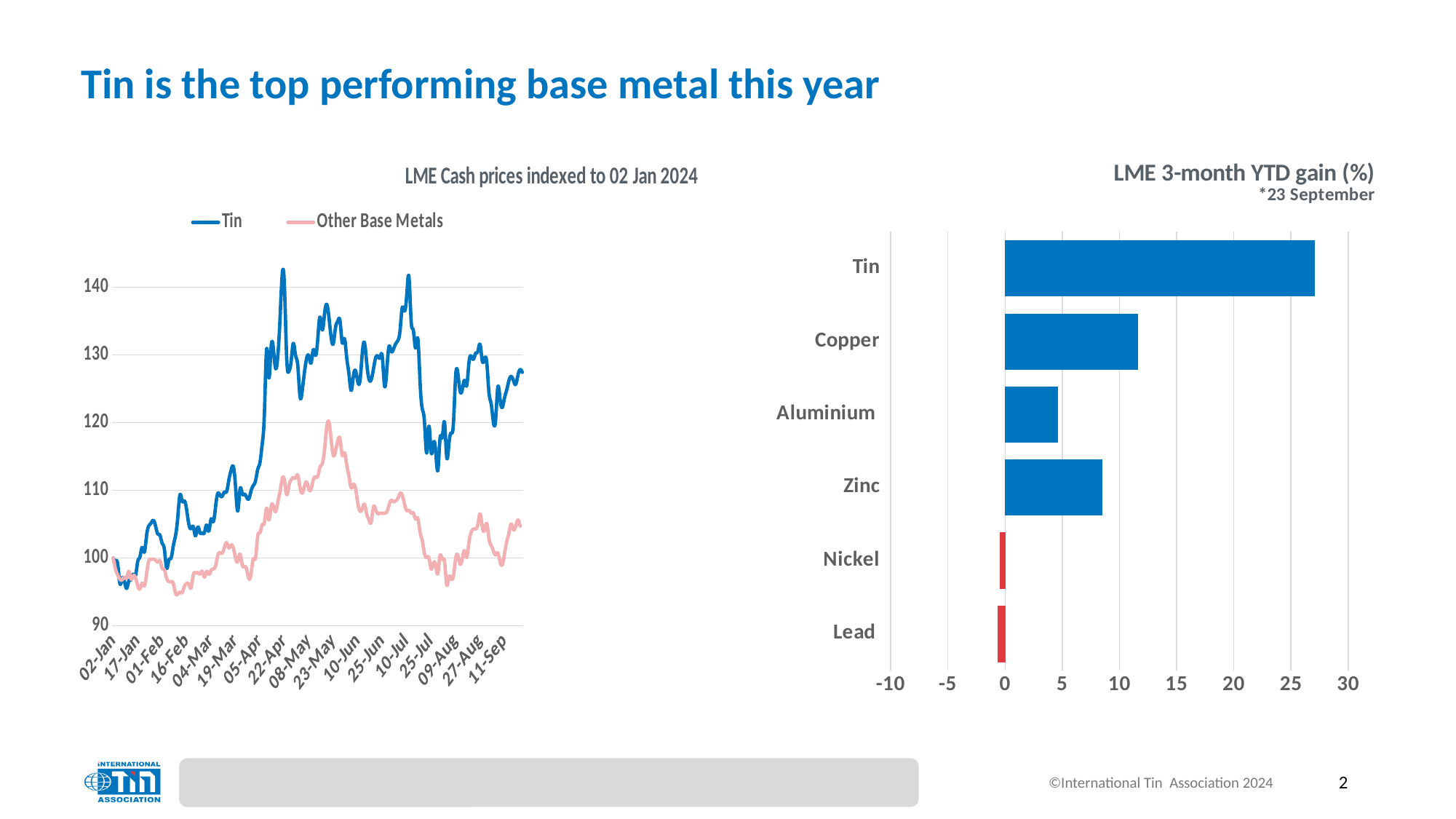
In the 'LME Cash prices indexed to 02 Jan 2024' chart, does the Tin line overall rise or fall from 02-Jan to 11-Sep? rise In the 'LME 3-month YTD gain (%)' chart, how many metals are shown? 6 In the 'LME 3-month YTD gain (%)' chart, which two metals are shown with red bars? Nickel and Lead What kind of chart is the 'LME 3-month YTD gain (%)' chart on the right? bar chart In the 'LME 3-month YTD gain (%)' chart, which has the larger YTD gain, Zinc or Aluminium? Zinc In the 'LME 3-month YTD gain (%)' chart, is the value for Tin greater or less than 25? greater In the 'LME 3-month YTD gain (%)' chart, is the value for Copper greater or less than 10? greater In the 'LME 3-month YTD gain (%)' chart, which metal has the highest YTD gain? Tin How many series does the legend of the 'LME Cash prices indexed to 02 Jan 2024' chart list? 2 In the 'LME 3-month YTD gain (%)' chart, which has the larger YTD gain, Copper or Zinc? Copper What kind of chart is the 'LME Cash prices indexed to 02 Jan 2024' chart on the left? line chart